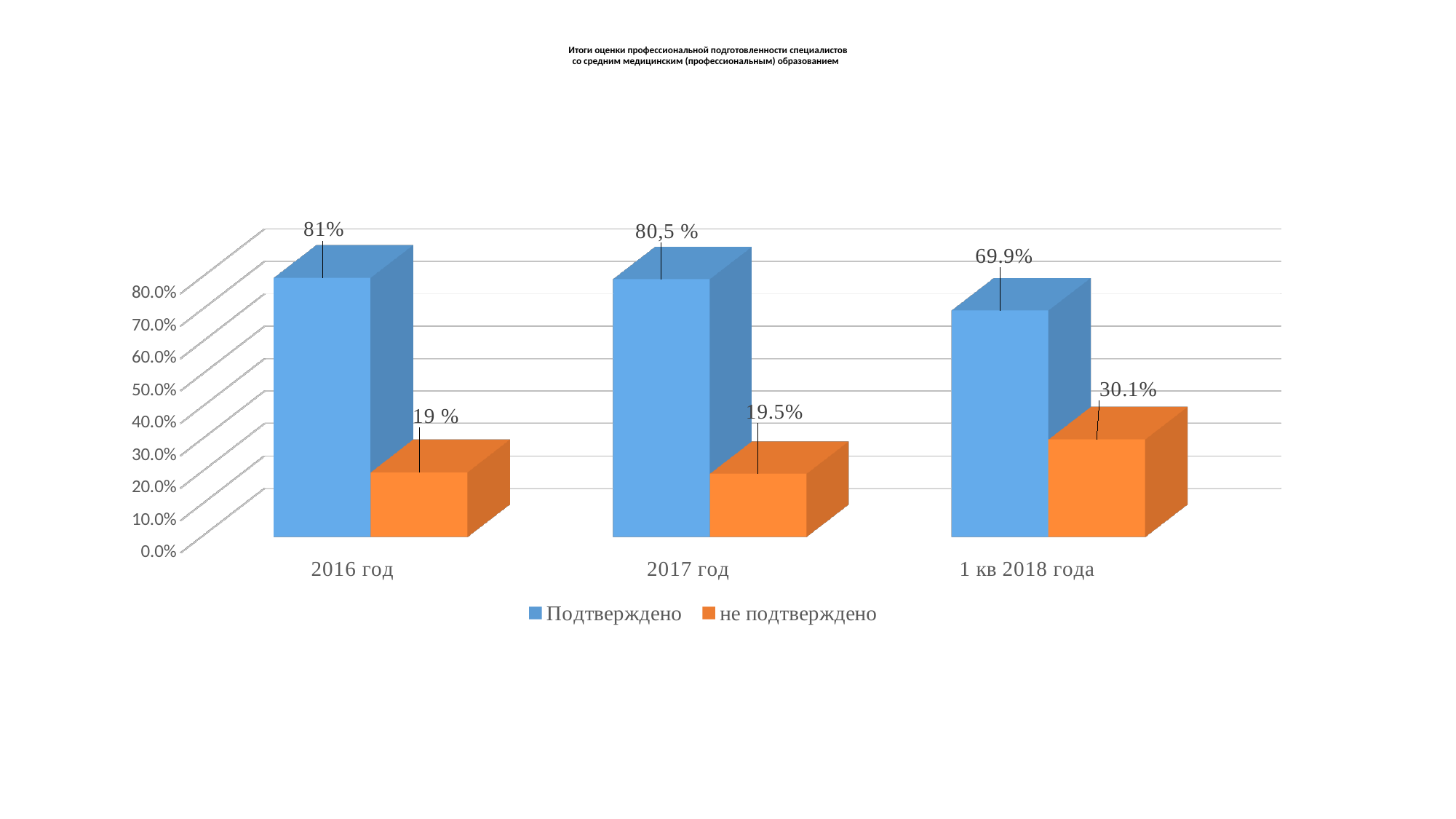
What is the value for Подтверждено in 2016 год? 81% How many categories are shown on the x axis? 3 Which is larger in 2016 год: Подтверждено or не подтверждено? Подтверждено What is the value for Подтверждено in 2017 год? 80,5 % What kind of chart is shown on the slide? Bar chart How many series does the legend list? 2 What is the value for не подтверждено in 1 кв 2018 года? 30.1% What is the value for не подтверждено in 2017 год? 19.5% What is the value for Подтверждено in 1 кв 2018 года? 69.9% In which category is the не подтверждено value highest? 1 кв 2018 года In which category is the Подтверждено value lowest? 1 кв 2018 года What is the difference between the не подтверждено values for 1 кв 2018 года and 2017 год? 10.6%